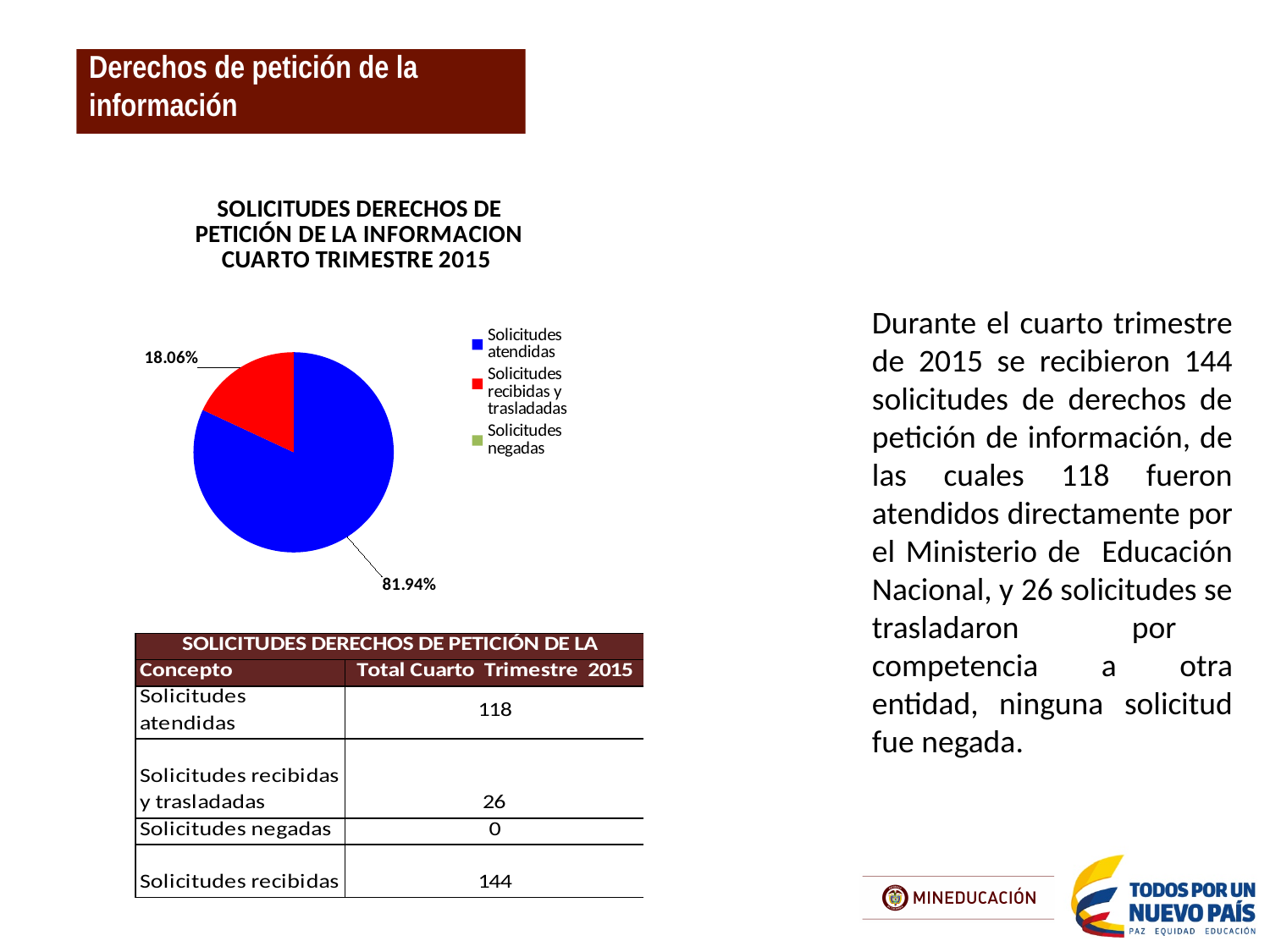
Which category has the largest slice in the pie chart? Solicitudes atendidas How many slices are visibly drawn in the pie chart? 2 Is the share for 'Solicitudes recibidas y trasladadas' greater or less than 25%? less What share of the pie does the 'Solicitudes recibidas y trasladadas' slice represent? 18.06% What type of chart is shown on the slide? pie chart What share of the pie does the 'Solicitudes atendidas' slice represent? 81.94% What is the title of the pie chart? SOLICITUDES DERECHOS DE PETICIÓN DE LA INFORMACION CUARTO TRIMESTRE 2015 How many entries does the legend of the pie chart list? 3 Is the share for 'Solicitudes atendidas' greater or less than 75%? greater Which colour represents 'Solicitudes atendidas' in the pie chart? blue What is the difference in percentage points between the 'Solicitudes atendidas' slice and the 'Solicitudes recibidas y trasladadas' slice? 63.88 Which of the two labelled slices is larger, 'Solicitudes atendidas' or 'Solicitudes recibidas y trasladadas'? Solicitudes atendidas